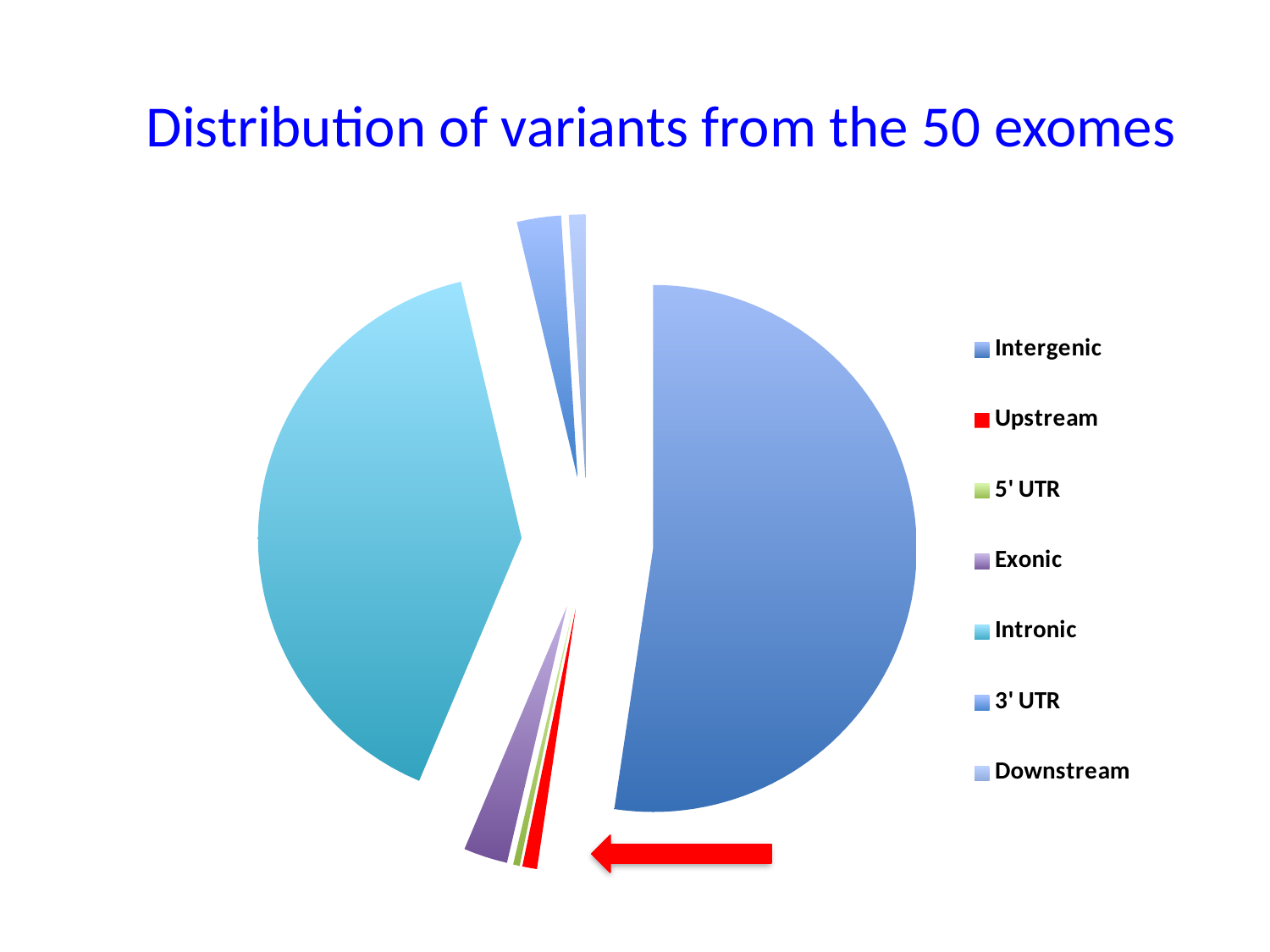
Which slice is larger, Intergenic or Intronic? Intergenic Which slice is larger, Intronic or 3' UTR? Intronic Which slice is larger, Exonic or Upstream? Exonic What kind of chart is shown on the slide? Pie chart Which category is shown in red in the legend? Upstream Which category is listed last in the legend? Downstream How many categories does the pie chart have? 7 What is the title of the chart? Distribution of variants from the 50 exomes Which category has the largest slice of the pie? Intergenic